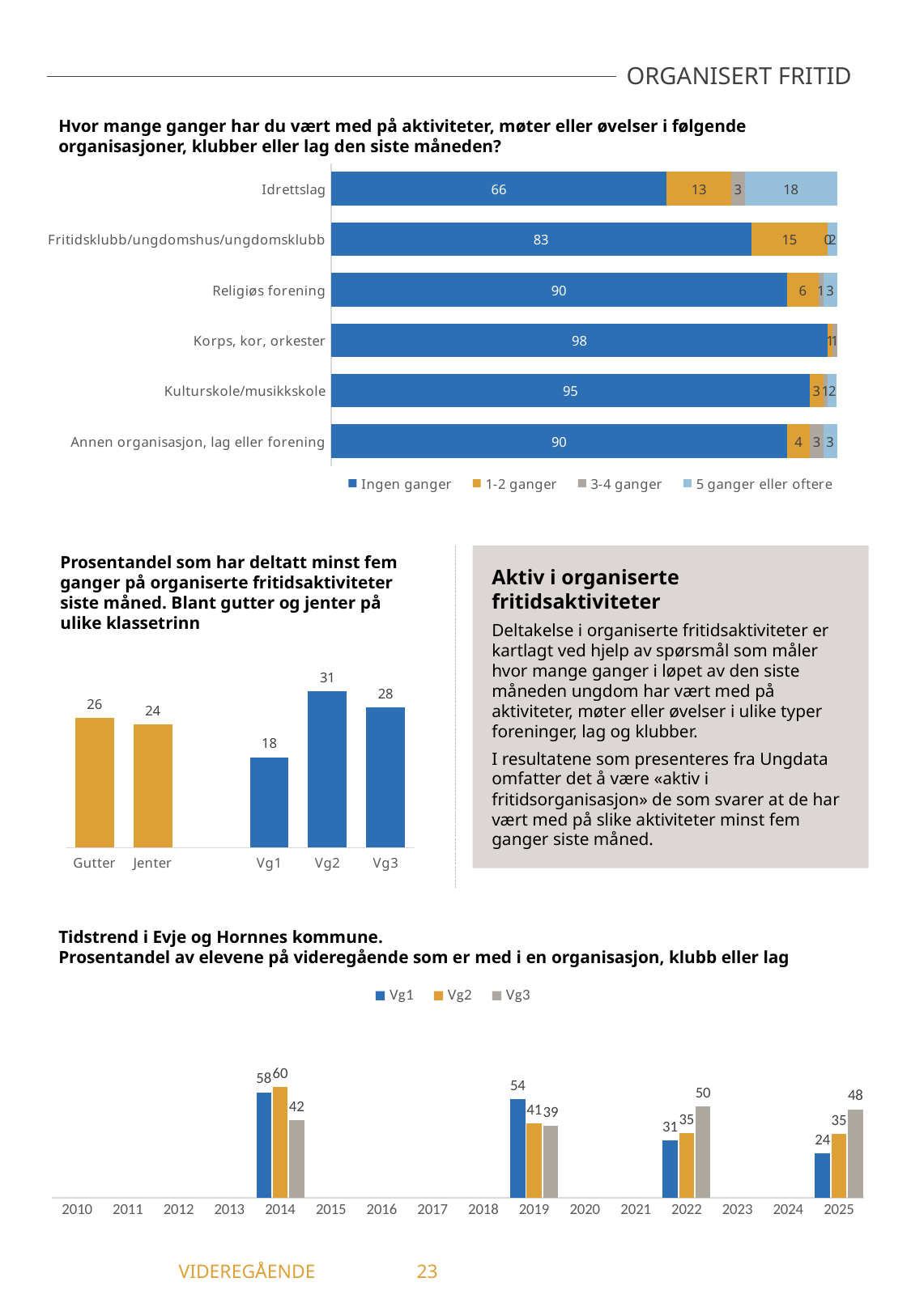
In the top chart, which category has the highest value for 'Ingen ganger'? Korps, kor, orkester In the bottom chart, which is larger in 2019: Vg1 or Vg2? Vg1 In the bottom chart, does the value for Vg1 rise or fall from 2014 to 2025? fall In the top chart, what is the value for '5 ganger eller oftere' for Idrettslag? 18 In the middle-left chart, what is the difference between the values for Gutter and Jenter? 2 In the top chart, how many categories are shown? 6 In the middle-left chart, which category has the lowest value? Vg1 In the top chart, how many series does the legend list? 4 In the top chart, what is the value for '1-2 ganger' for Fritidsklubb/ungdomshus/ungdomsklubb? 15 In the bottom chart (Tidstrend i Evje og Hornnes kommune), what is the value for Vg3 in 2025? 48 In the top chart (Hvor mange ganger har du vært med på aktiviteter...), what is the value for 'Ingen ganger' for Idrettslag? 66 In the middle-left chart (Prosentandel som har deltatt minst fem ganger...), what is the value for Vg2? 31